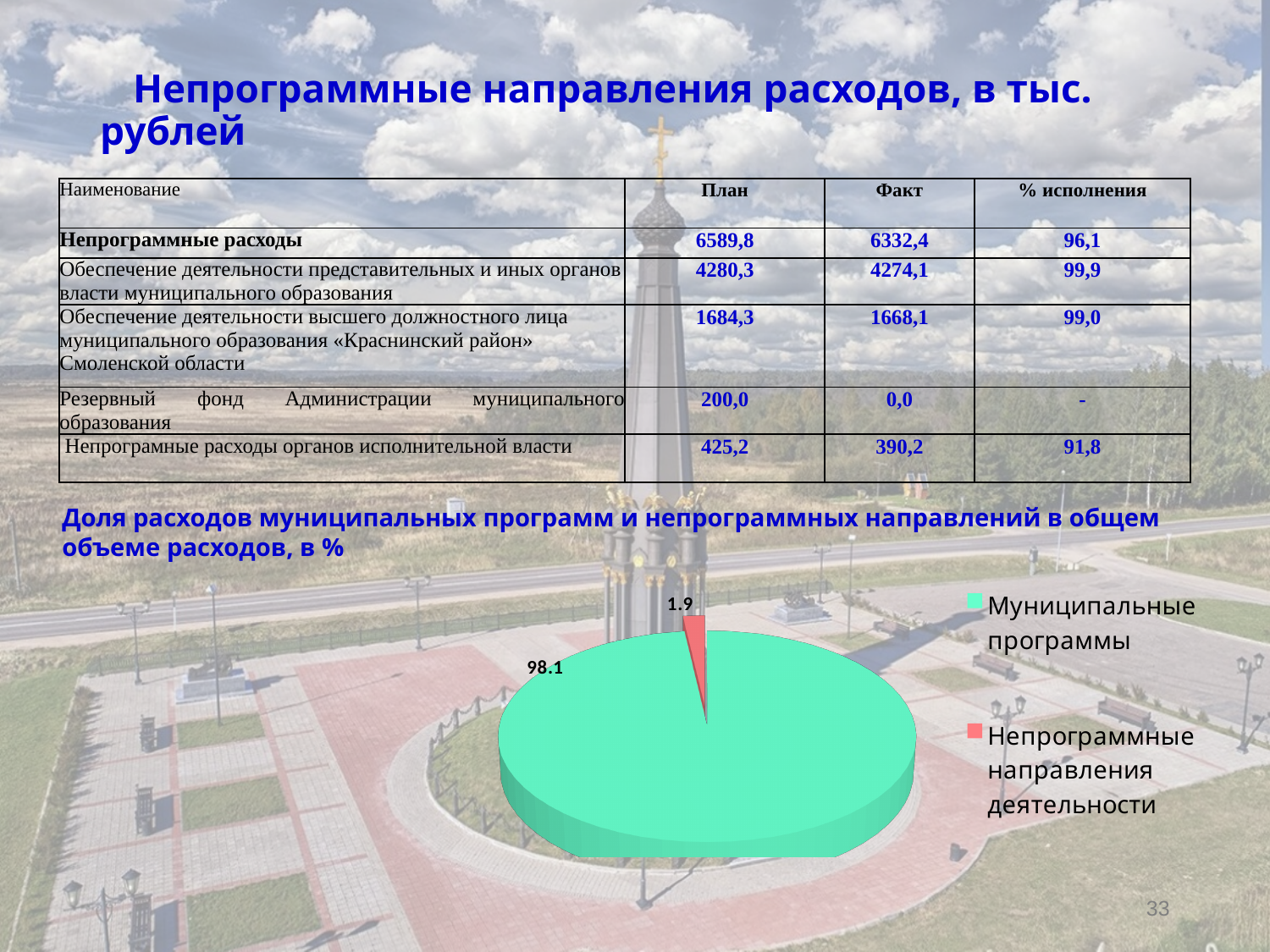
What is the title of the pie chart? Доля расходов муниципальных программ и непрограммных направлений в общем объеме расходов, в % What is the value for Непрограммные направления деятельности in the pie chart? 1.9 Which category has the smallest slice in the pie chart? Непрограммные направления деятельности How many slices does the pie chart have? 2 What kind of chart is shown on the slide? pie chart Which is larger in the pie chart: Муниципальные программы or Непрограммные направления деятельности? Муниципальные программы What colour is the slice for Непрограммные направления деятельности in the pie chart? red What is the value for Муниципальные программы in the pie chart? 98.1 Which category has the largest slice in the pie chart? Муниципальные программы What is the total of the two slice values in the pie chart? 100 How many entries does the pie chart legend list? 2 What is the difference between the values for Муниципальные программы and Непрограммные направления деятельности in the pie chart? 96.2